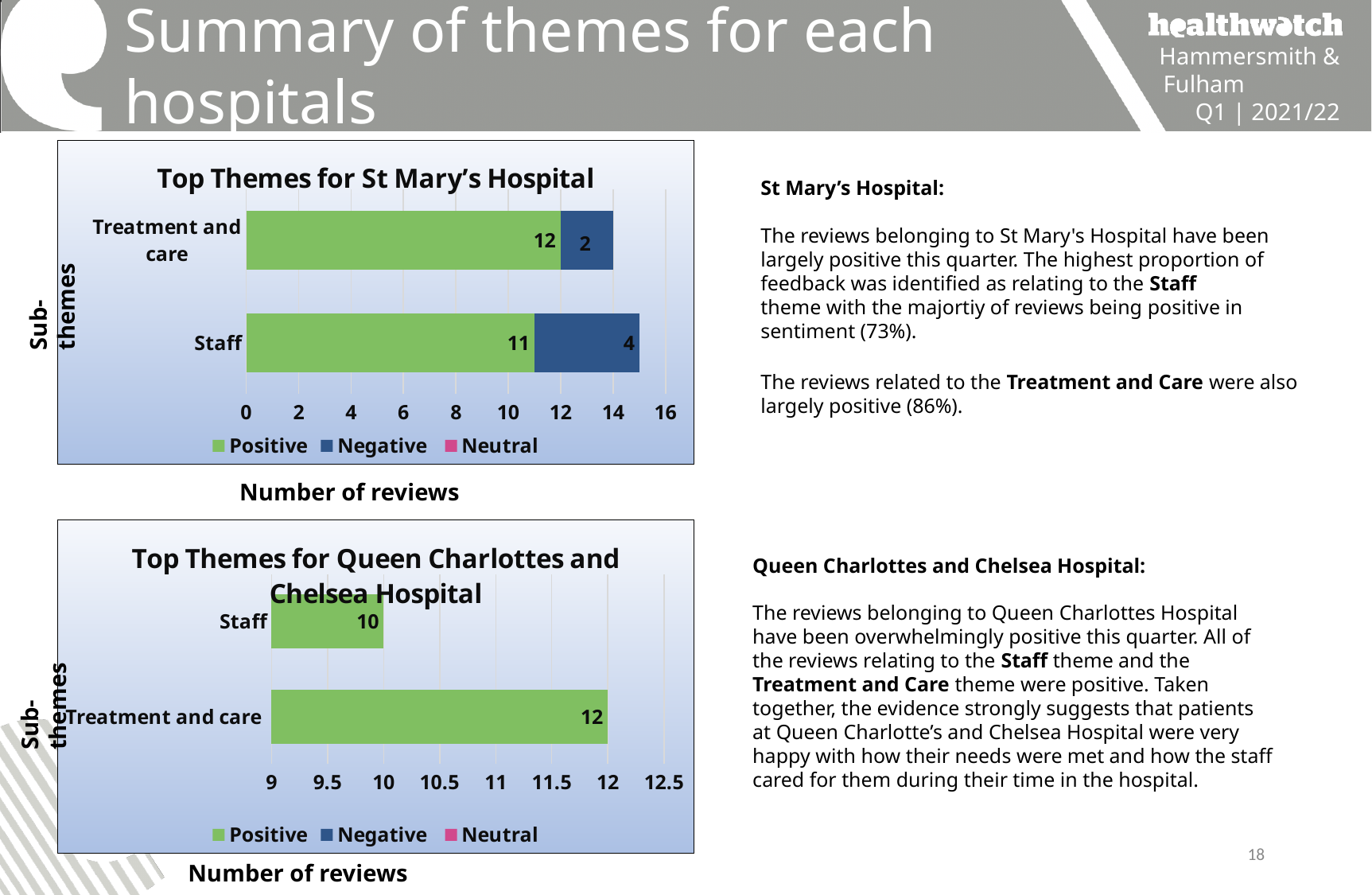
How many series does the legend list in the 'Top Themes for St Mary's Hospital' chart? 3 What kind of chart is 'Top Themes for St Mary's Hospital'? Stacked bar chart How many sub-themes are plotted in the 'Top Themes for Queen Charlottes and Chelsea Hospital' chart? 2 In the 'Top Themes for St Mary's Hospital' chart, what is the difference between the Negative reviews for Staff and for Treatment and care? 2 In the 'Top Themes for Queen Charlottes and Chelsea Hospital' chart, which sub-theme has the highest number of reviews? Treatment and care In the 'Top Themes for St Mary's Hospital' chart, how many Positive reviews are shown for Staff? 11 In the 'Top Themes for St Mary's Hospital' chart, what is the total number of reviews in the Staff bar? 15 In the 'Top Themes for Queen Charlottes and Chelsea Hospital' chart, how many Positive reviews are shown for Staff? 10 In the 'Top Themes for St Mary's Hospital' chart, what is the total number of reviews in the Treatment and care bar? 14 In the 'Top Themes for St Mary's Hospital' chart, which sub-theme has more Positive reviews, Staff or Treatment and care? Treatment and care In the 'Top Themes for St Mary's Hospital' chart, how many Negative reviews are shown for Treatment and care? 2 In the 'Top Themes for Queen Charlottes and Chelsea Hospital' chart, what is the difference between the reviews for Treatment and care and for Staff? 2